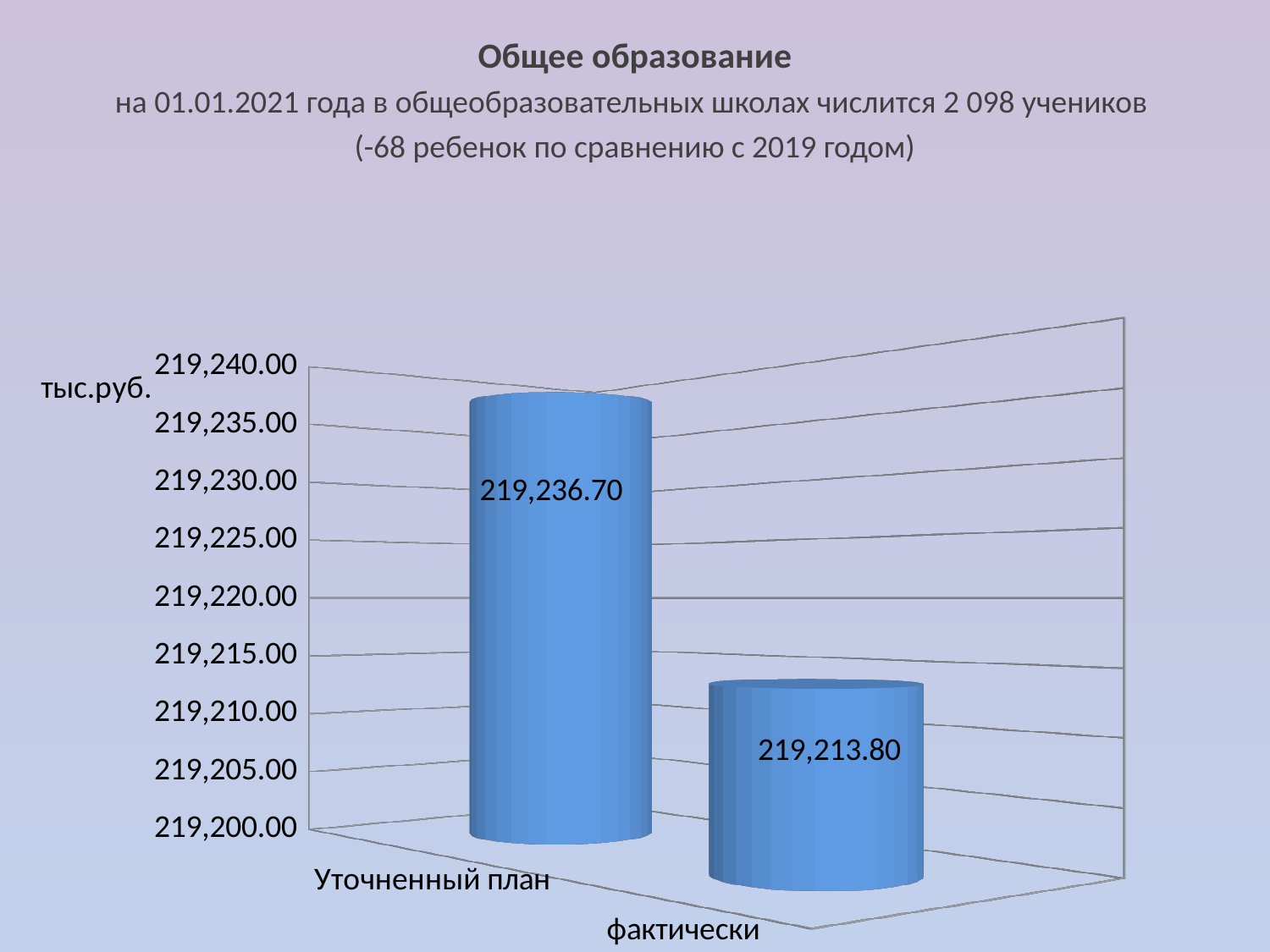
How many categories are shown in the chart? 2 Is the value for Уточненный план greater or less than 219,230.00? greater What is the value for фактически? 219,213.80 What is the value for Уточненный план? 219,236.70 Which category has the highest value? Уточненный план Is the value for фактически greater or less than 219,220.00? less Which category has the lowest value? фактически What is the difference between the values for Уточненный план and фактически? 22.90 What is the title of the slide? Общее образование What kind of chart is shown on the slide? bar chart What unit is shown on the vertical axis of the chart? тыс.руб. Which is larger, the value for Уточненный план or the value for фактически? Уточненный план